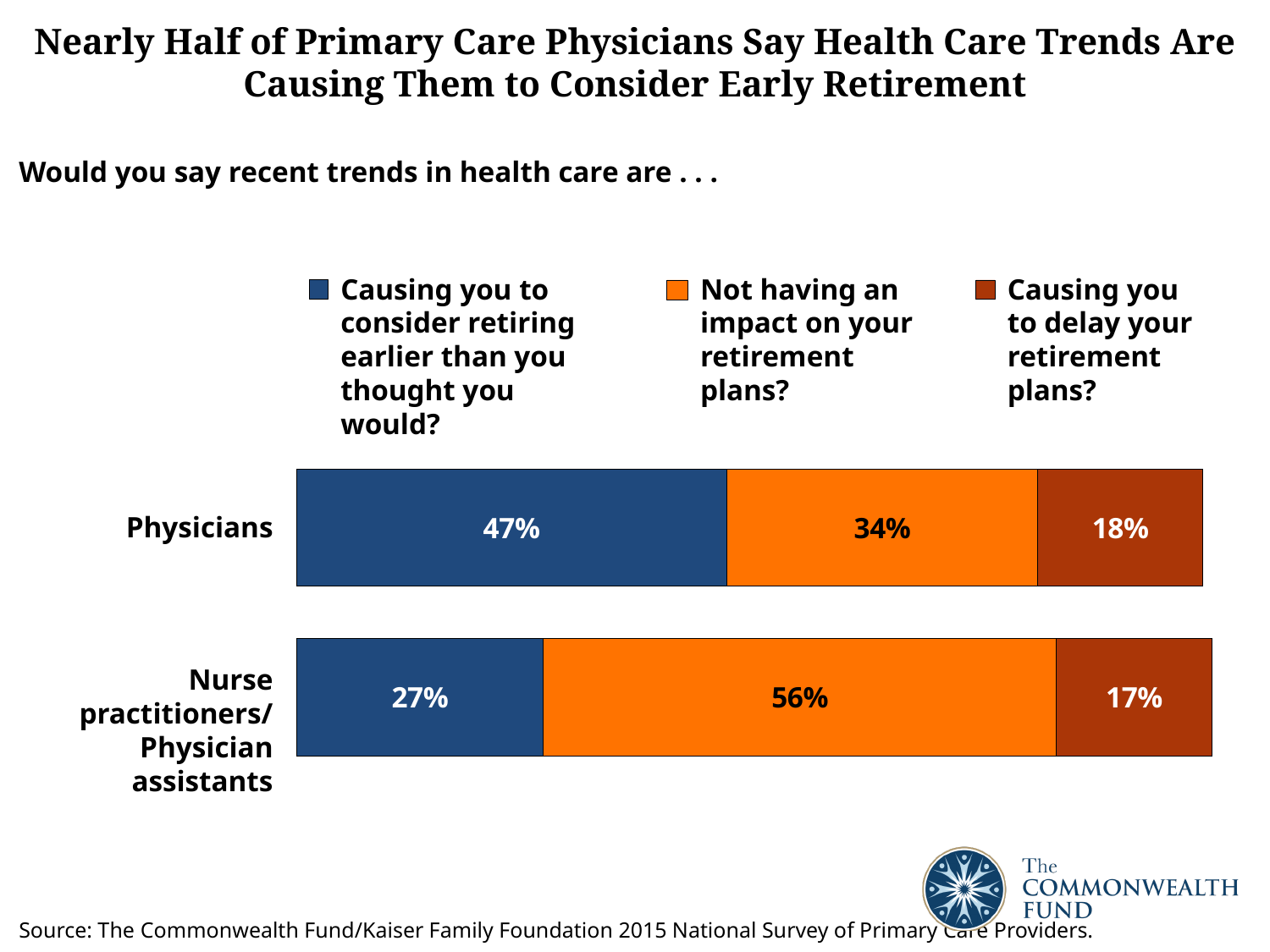
Which response category is the largest for physicians? Causing you to consider retiring earlier than you thought you would What percentage of physicians say recent health care trends are causing them to delay their retirement plans? 18% How many series does the legend list? 3 What percentage of nurse practitioners/physician assistants say recent health care trends are causing them to consider retiring earlier than they thought they would? 27% What kind of chart is shown on the slide? Stacked bar chart What percentage of physicians say recent health care trends are causing them to consider retiring earlier than they thought they would? 47% What percentage of nurse practitioners/physician assistants say recent health care trends are not having an impact on their retirement plans? 56% What is the difference in percentage points between nurse practitioners/physician assistants and physicians who say trends are not having an impact on their retirement plans? 22 percentage points How many provider groups are shown in the chart? 2 Which response category is the smallest for nurse practitioners/physician assistants? Causing you to delay your retirement plans What is the difference in percentage points between physicians and nurse practitioners/physician assistants who say trends are causing them to consider retiring earlier? 20 percentage points Which group has the higher share saying health care trends are causing them to consider retiring earlier: physicians or nurse practitioners/physician assistants? Physicians